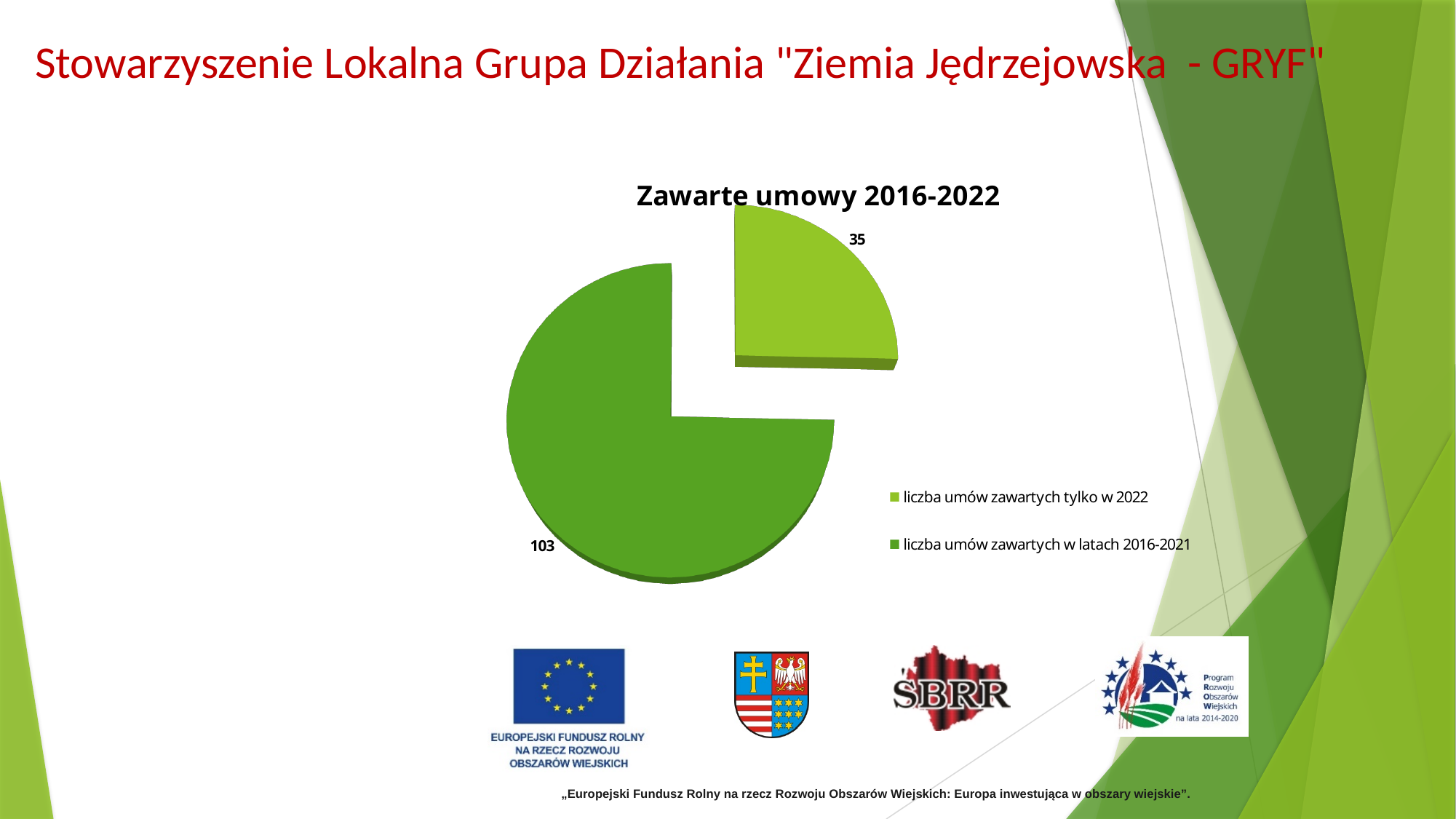
Which category has the smallest slice in the pie chart? liczba umów zawartych tylko w 2022 What is the value for 'liczba umów zawartych w latach 2016-2021'? 103 What is the total number of contracts shown across both slices of the pie chart? 138 Which legend entry is shown in the lighter green colour? liczba umów zawartych tylko w 2022 What kind of chart is shown on the slide? pie chart What is the value for 'liczba umów zawartych tylko w 2022'? 35 What is the difference between the number of contracts concluded in 2016-2021 and those concluded only in 2022? 68 What is the title of the pie chart? Zawarte umowy 2016-2022 How many slices does the pie chart have? 2 Which category has the largest slice in the pie chart? liczba umów zawartych w latach 2016-2021 Which is larger: the number of contracts concluded only in 2022 or the number concluded in 2016-2021? liczba umów zawartych w latach 2016-2021 How many entries does the legend of the pie chart list? 2